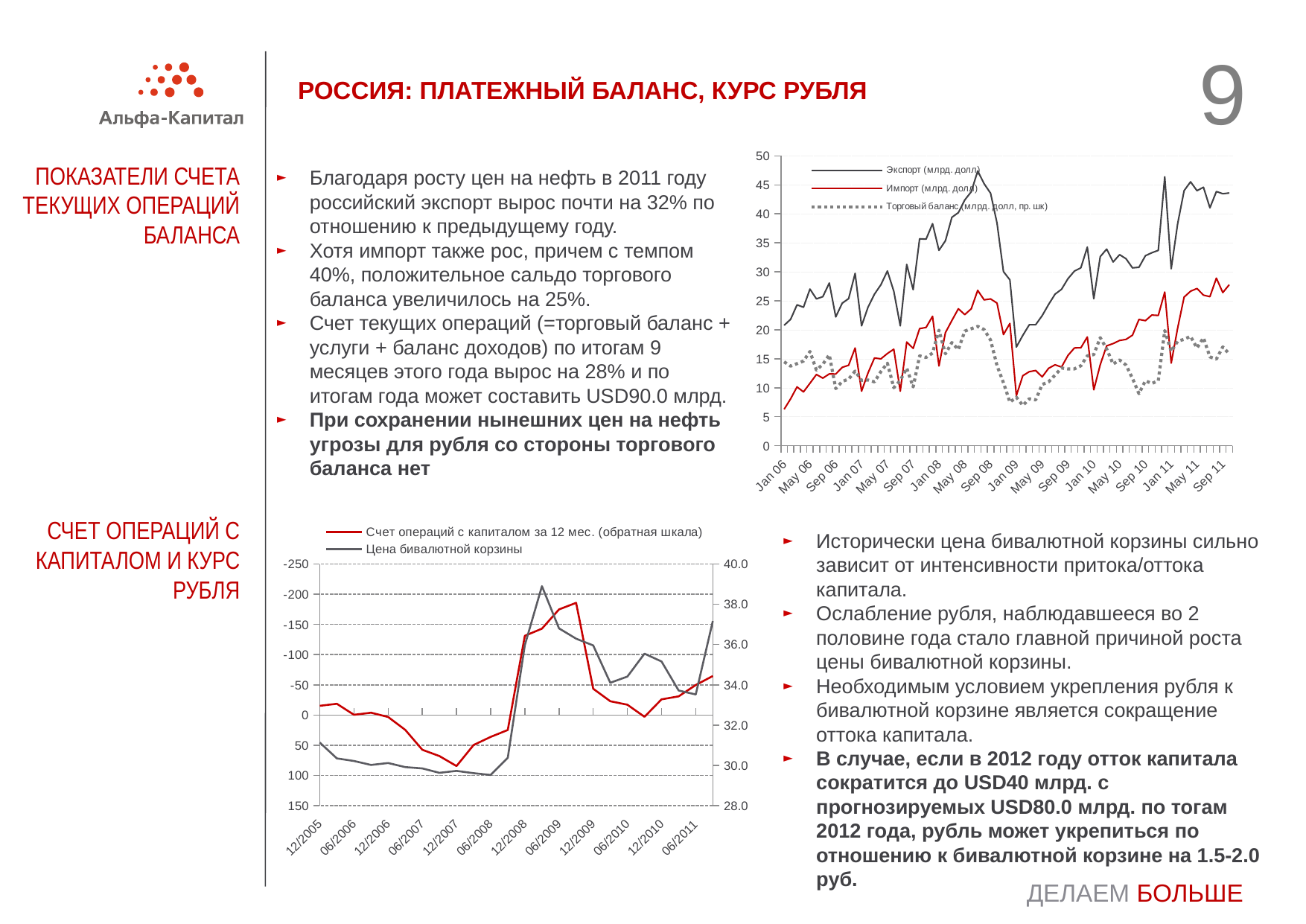
How many series does the legend of the bottom-left chart list? 2 In the top-right chart, which series is drawn as a dotted line? Торговый баланс (млрд. долл, пр. шк) In the top-right chart, which is larger at Sep 11, Экспорт or Импорт? Экспорт In the bottom-left chart, is the peak value of Цена бивалютной корзины in early 2009 greater or less than 38.0? greater In the top-right chart, is the value of Импорт at Jan 06 greater or less than 10? less In the bottom-left chart, does Цена бивалютной корзины overall rise or fall from 12/2005 to the end of the series? rise How many series does the legend of the top-right chart list? 3 In the top-right chart, is the value of Экспорт at Jan 09 greater or less than 20? less What kind of chart is the top-right chart showing exports and imports? line chart What kind of chart is the bottom-left chart showing the capital account and the bi-currency basket price? line chart